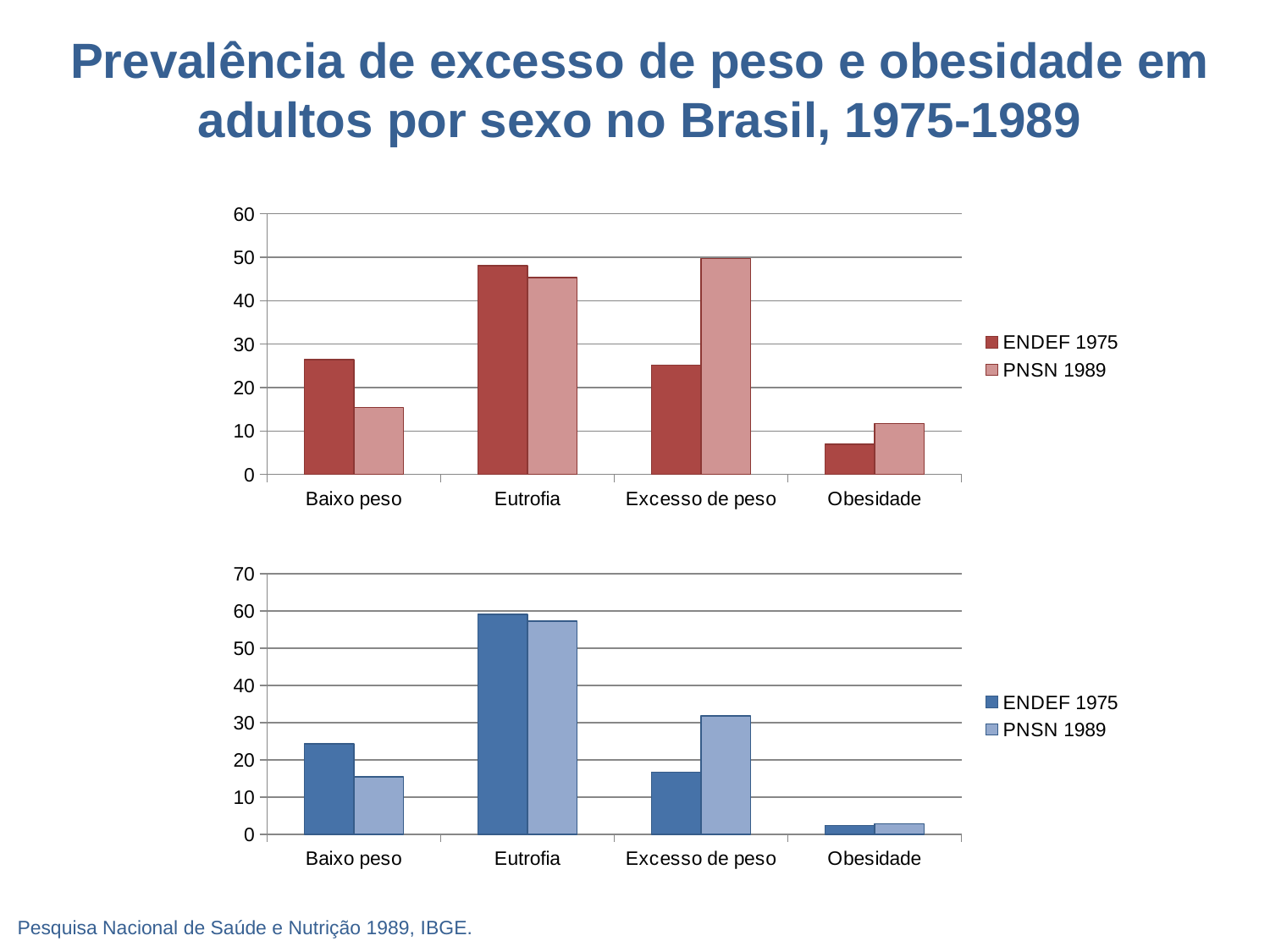
What kind of chart is the top chart on the slide? bar chart How many series does the legend of the top chart list? 2 In the bottom chart, which category has the highest PNSN 1989 value? Eutrofia In the top chart, for Excesso de peso, which series is larger: ENDEF 1975 or PNSN 1989? PNSN 1989 How many categories are shown on the x axis of the bottom chart? 4 In the top chart, which category has the highest ENDEF 1975 value? Eutrofia In the top chart, which category has the lowest PNSN 1989 value? Obesidade In the top chart, is the PNSN 1989 value for Excesso de peso greater or less than 40? greater In the bottom chart, which category has the lowest ENDEF 1975 value? Obesidade In the bottom chart, is the ENDEF 1975 value for Excesso de peso greater or less than 20? less In the bottom chart, for Baixo peso, which series is larger: ENDEF 1975 or PNSN 1989? ENDEF 1975 What are the two legend entries of the bottom chart? ENDEF 1975 and PNSN 1989